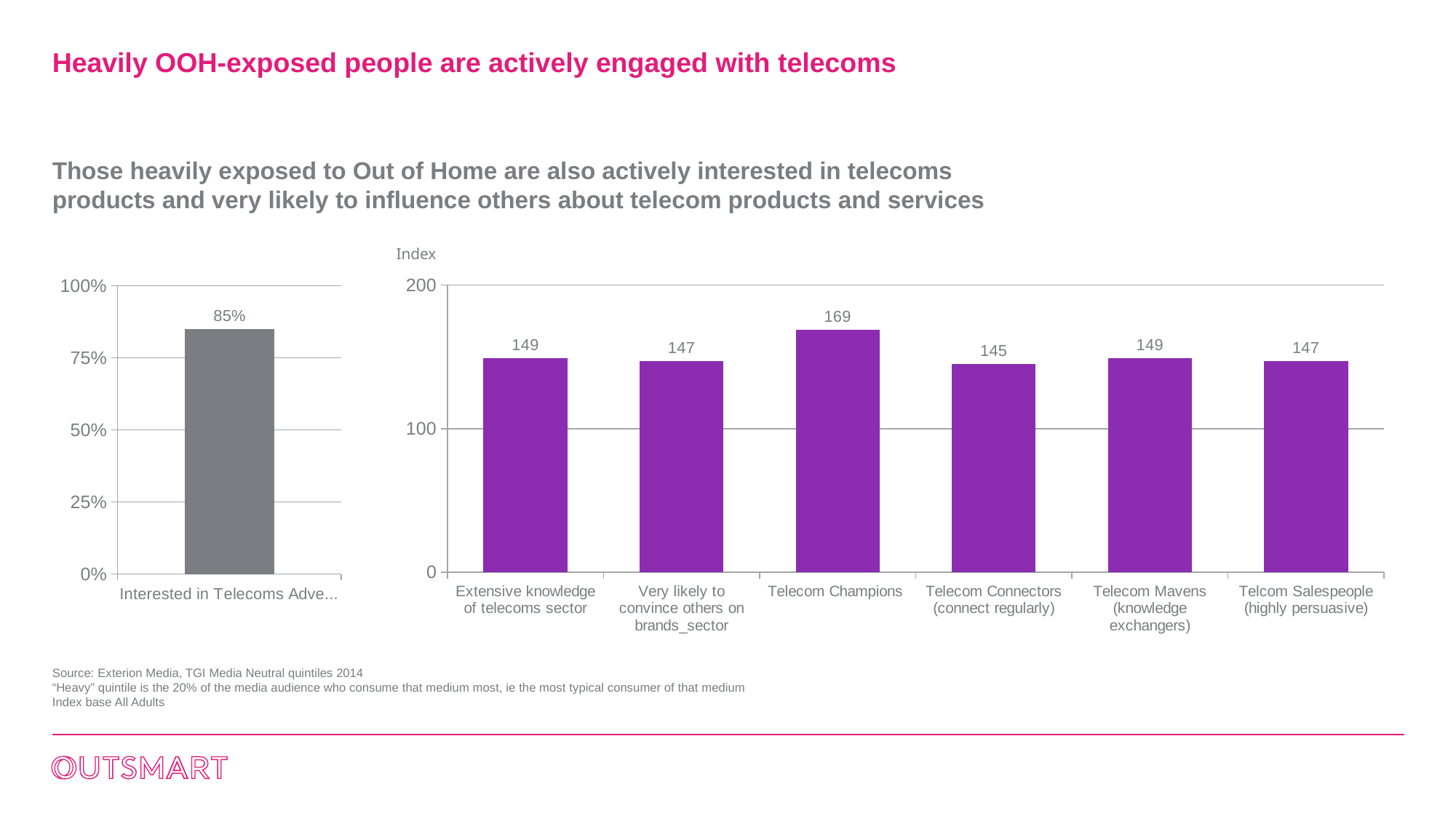
In the right-hand chart, what is the difference between the index values for Telecom Champions and Telecom Connectors (connect regularly)? 24 In the right-hand chart, which category has the lowest index value? Telecom Connectors (connect regularly) How many categories are shown in the right-hand chart? 6 In the left-hand chart, what is the value shown for the single bar? 85% In the right-hand chart, which category has the highest index value? Telecom Champions In the right-hand chart, what is the index value for Telecom Connectors (connect regularly)? 145 In the right-hand chart, what is the index value for Telecom Champions? 169 In the right-hand chart, what is the index value for Extensive knowledge of telecoms sector? 149 What is the axis label shown above the vertical axis of the right-hand chart? Index What type of chart is the right-hand chart? Bar chart In the right-hand chart, which has a higher index value: Telecom Champions or Telecom Mavens (knowledge exchangers)? Telecom Champions In the right-hand chart, is the index value for Telcom Salespeople (highly persuasive) greater or less than 100? greater